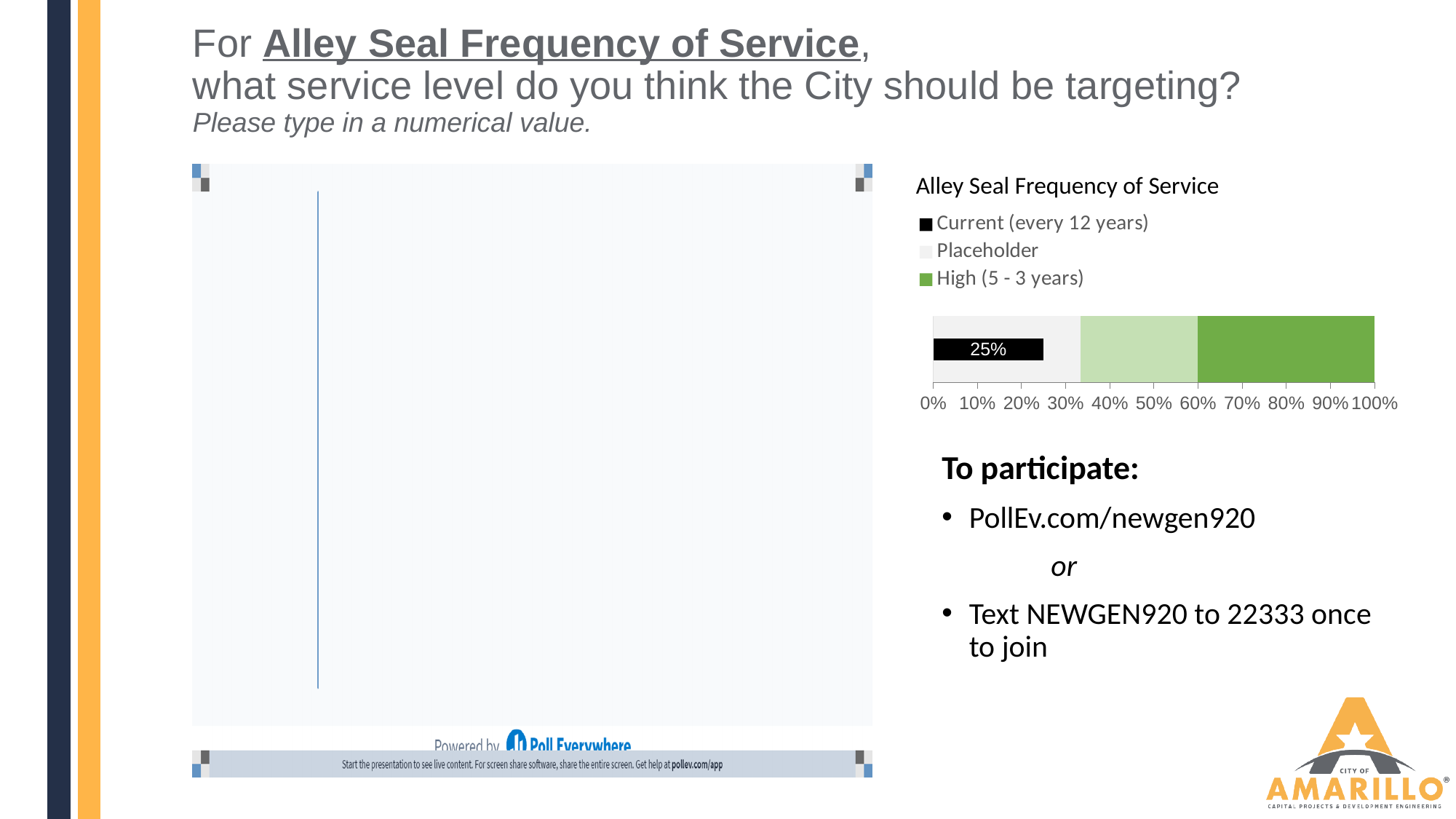
In the Alley Seal Frequency of Service chart, what frequency is given in the legend for the Current service level? every 12 years What is the highest value shown on the x axis of the Alley Seal Frequency of Service chart? 100% In the Alley Seal Frequency of Service chart, is the value for Current (every 12 years) greater or less than 30%? less In the Alley Seal Frequency of Service chart, is the value for Current (every 12 years) greater or less than 20%? greater In the Alley Seal Frequency of Service chart, what value is printed on the black bar for Current (every 12 years)? 25% What type of chart is the Alley Seal Frequency of Service chart? bar chart What is the title of the chart on the right side of the slide? Alley Seal Frequency of Service How many series does the legend of the Alley Seal Frequency of Service chart list? 3 In the Alley Seal Frequency of Service chart, which legend entry is shown in green? High (5 - 3 years)